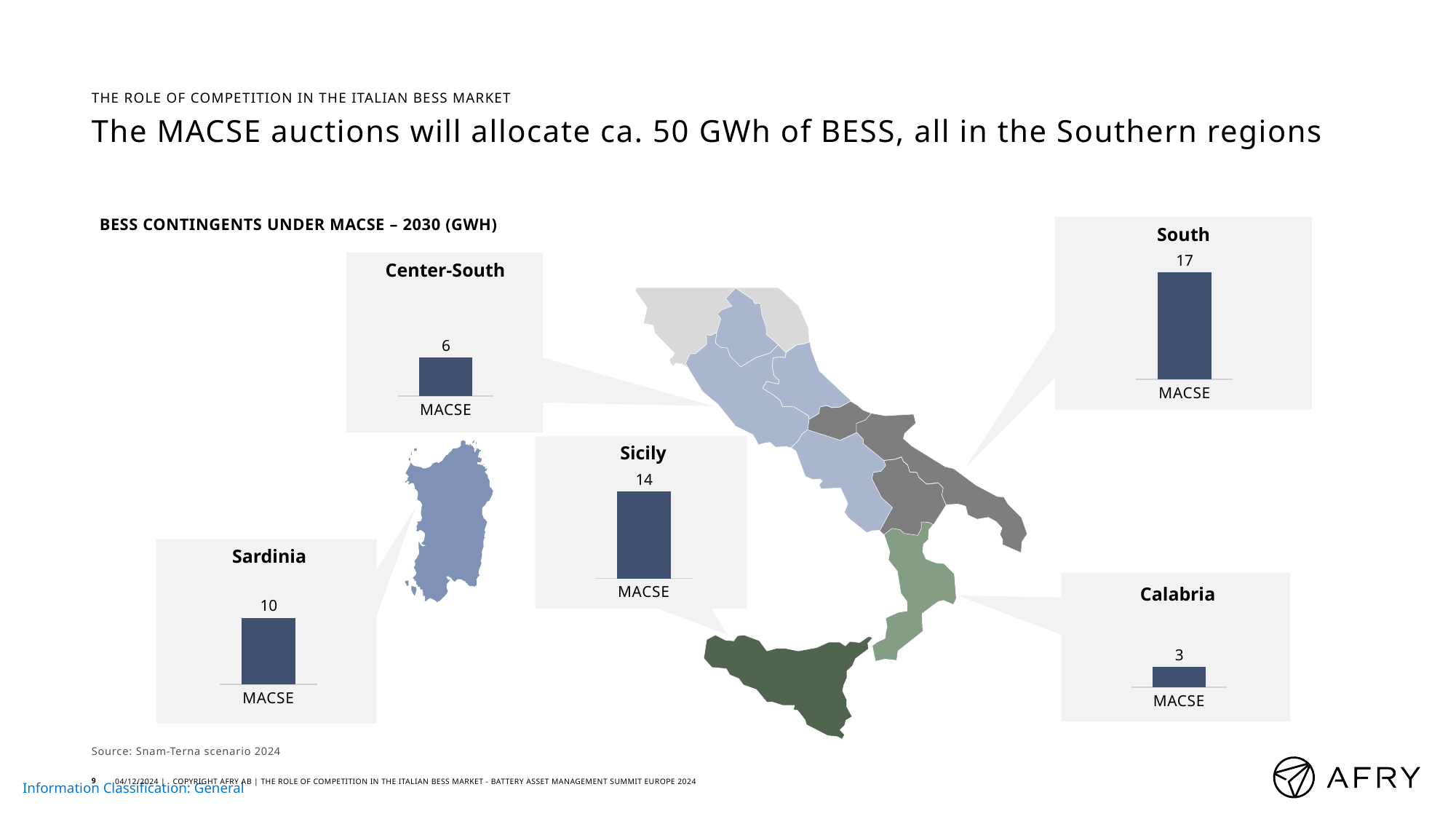
What is the difference between the Sardinia chart's MACSE value and the Calabria chart's MACSE value? 7 In the South chart, what is the value of the MACSE bar? 17 What is the difference between the South chart's MACSE value and the Sicily chart's MACSE value? 3 In the Calabria chart, what is the value of the MACSE bar? 3 What type of chart is used in each regional box on the slide? Bar chart Across the five regional charts, which region has the lowest MACSE value? Calabria Which is larger: the MACSE value in the Sardinia chart or in the Center-South chart? Sardinia How many regional charts are shown on the slide? 5 Across the five regional charts, which region has the highest MACSE value? South In the Center-South chart, what is the value of the MACSE bar? 6 In the Sicily chart, what is the value of the MACSE bar? 14 In the Sardinia chart, what is the value of the MACSE bar? 10